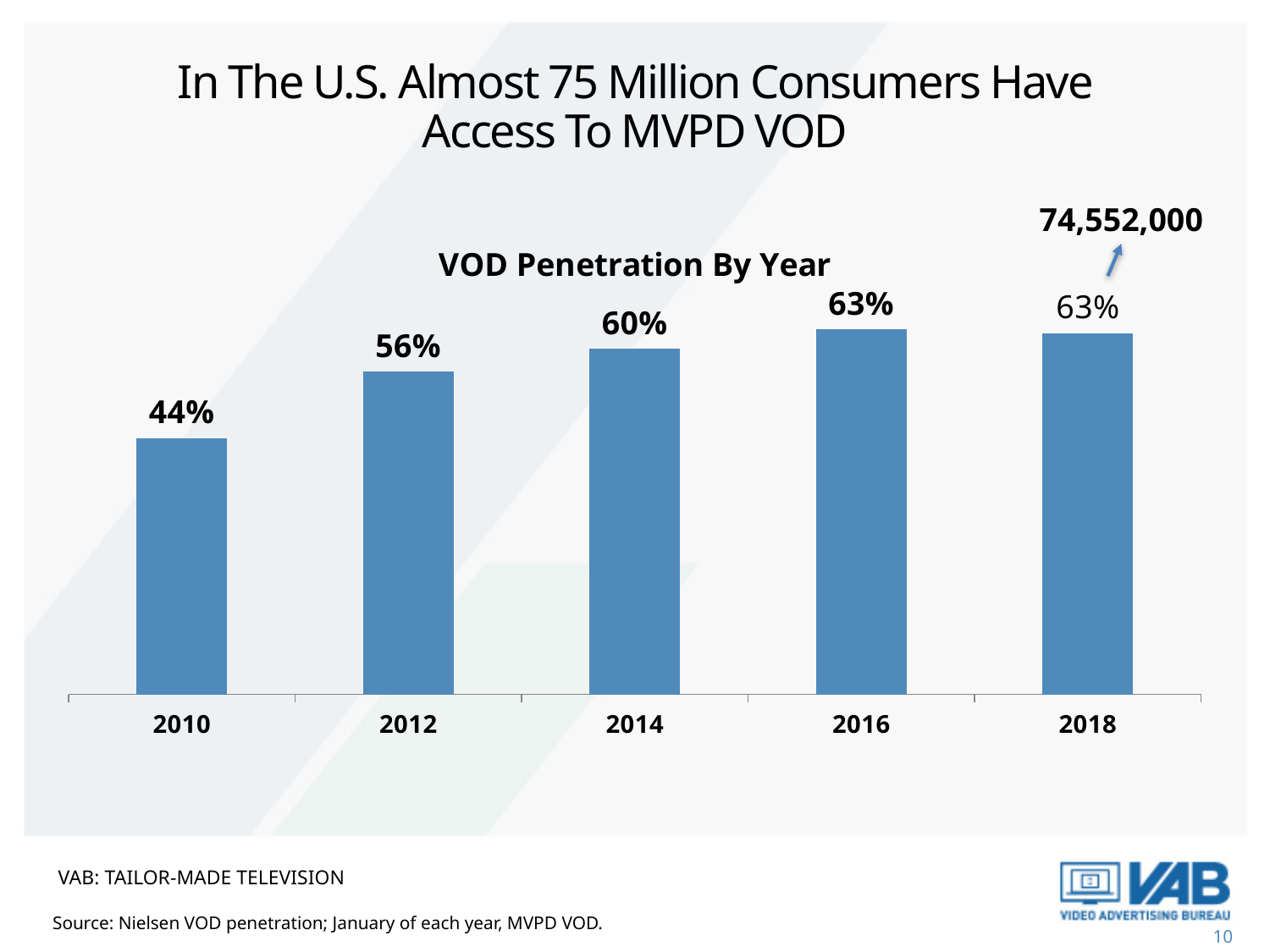
Do the VOD penetration values generally rise or fall from 2010 to 2018? Rise What is the title of the chart? VOD Penetration By Year How many years are shown on the x axis of the chart? 5 What is the difference in VOD penetration between 2012 and 2010? 12% What number is annotated above the 2018 bar? 74,552,000 What is the VOD penetration value for 2014? 60% What is the VOD penetration value for 2018? 63% Which is larger, the VOD penetration in 2012 or in 2014? 2014 Which year has the lowest VOD penetration? 2010 What is the VOD penetration value for 2010? 44% What kind of chart is shown on the slide? Bar chart What is the difference in VOD penetration between 2016 and 2014? 3%